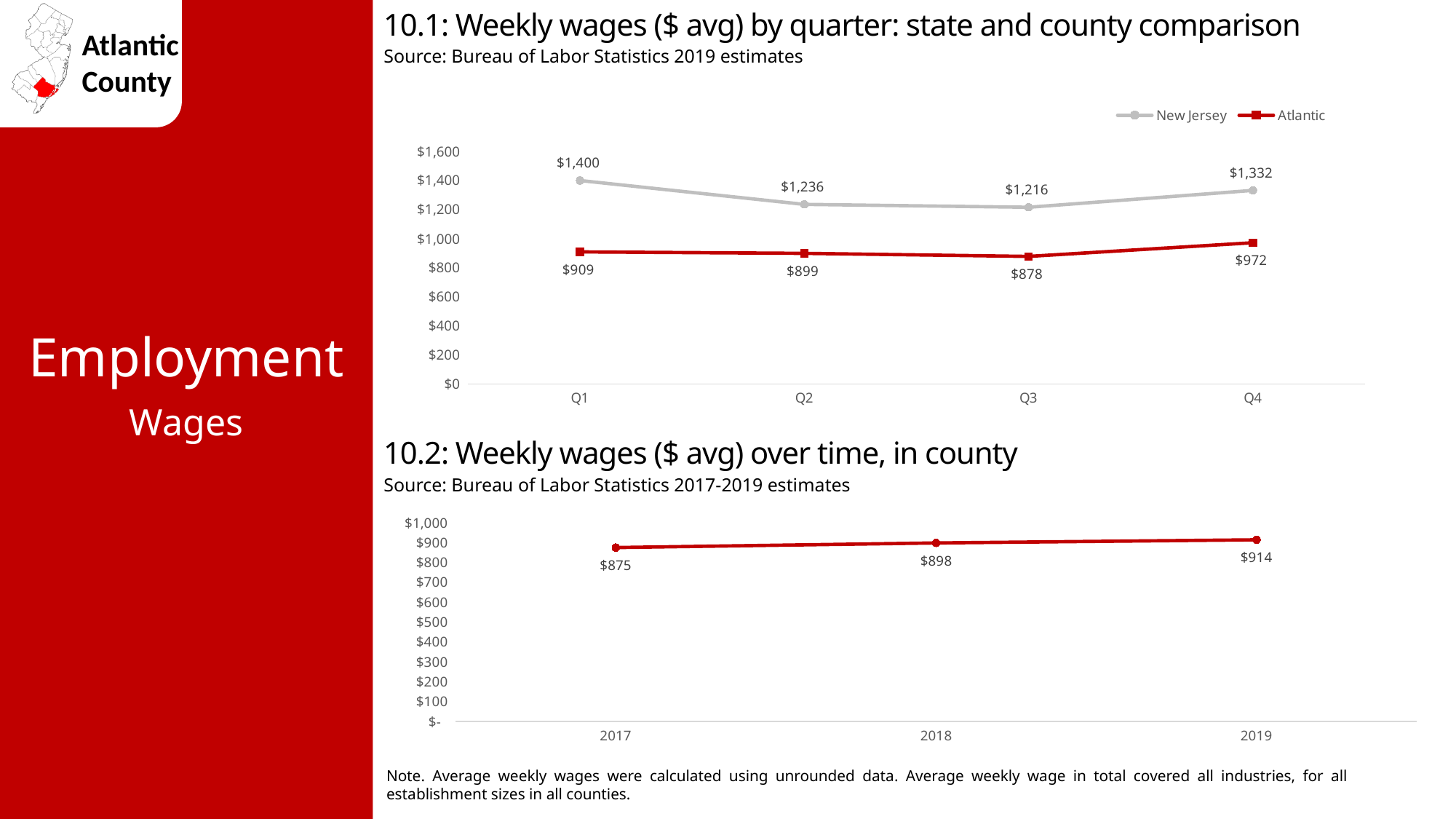
In chart 10.1, which quarter has the highest Atlantic weekly wage? Q4 In chart 10.2, what is the difference between the 2019 and 2017 weekly wages? $39 In chart 10.1, which quarter has the lowest New Jersey weekly wage? Q3 In chart 10.2, do weekly wages rise or fall from 2017 to 2019? Rise In chart 10.1, what is the Atlantic weekly wage in Q3? $878 In chart 10.1, what type of chart is shown? Line chart In chart 10.1, how many series does the legend list? 2 In chart 10.1, what is the New Jersey weekly wage in Q1? $1,400 In chart 10.2, what is the weekly wage in 2018? $898 In chart 10.2, how many years are plotted? 3 In chart 10.1, what is the difference between the New Jersey and Atlantic weekly wages in Q4? $360 In chart 10.1, which series is drawn in red? Atlantic